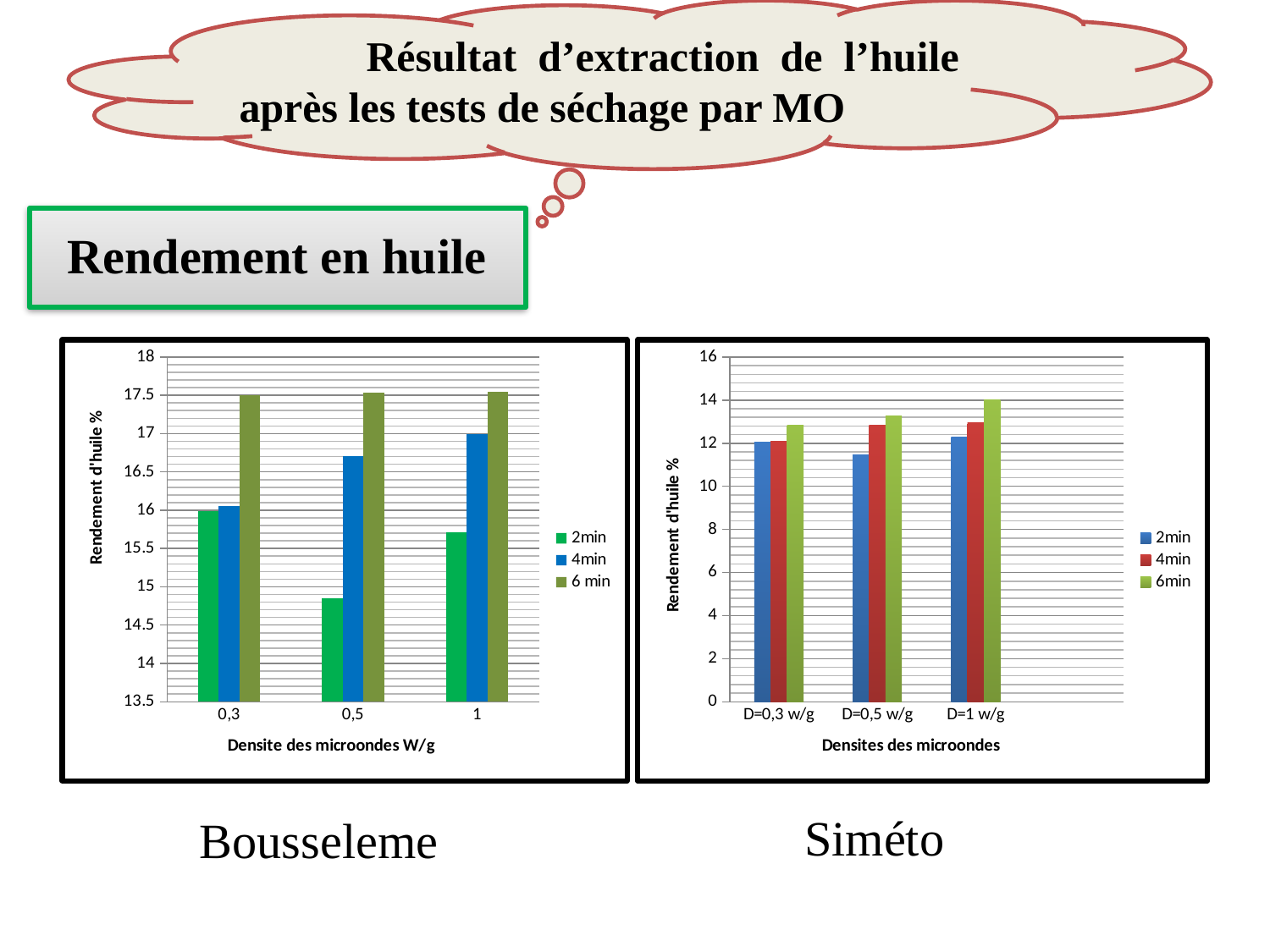
In the Bousseleme chart, is the 6 min value at density 0,3 greater or less than 17? greater In the Siméto chart, does the 6min value rise or fall as the density increases from D=0,3 w/g to D=1 w/g? rise In the Bousseleme chart, is the 2min value at density 0,5 greater or less than 15? less What is the x-axis title of the Bousseleme chart? Densite des microondes W/g How many microwave density categories are shown on the x axis of the Bousseleme chart? 3 In the Siméto chart, at which density is the 6min value highest? D=1 w/g In the Siméto chart, at D=0,5 w/g, which is larger: the 2min value or the 6min value? 6min How many series does the legend of the Siméto chart list? 3 What type of chart is the Bousseleme chart on the left? bar chart In the Siméto chart, is the 2min value at D=0,5 w/g greater or less than 12? less In the Bousseleme chart, at which density is the 2min value lowest? 0,5 In the Bousseleme chart, is the 4min value larger at density 0,3 or at density 0,5? 0,5